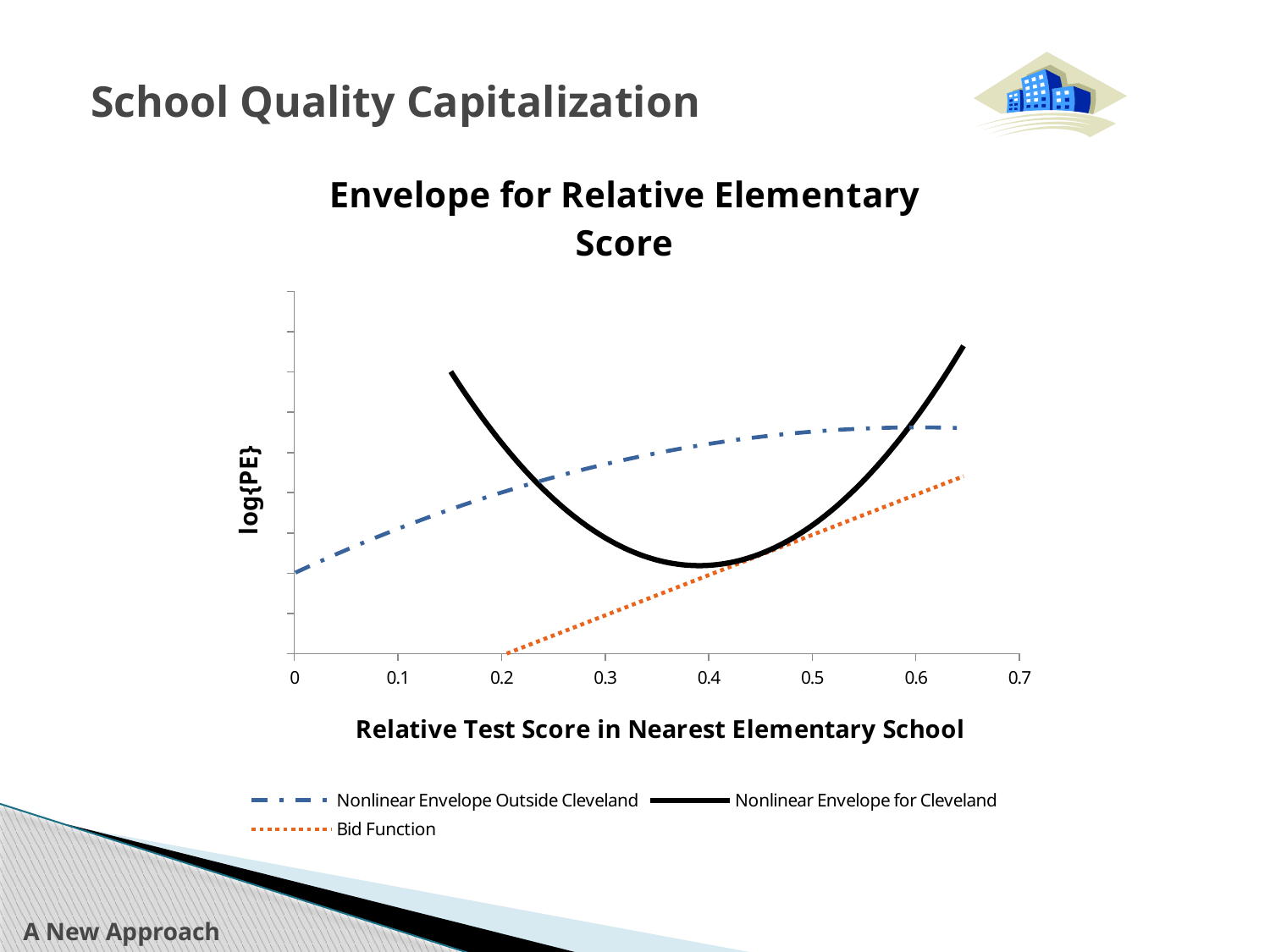
What is the title of the chart? Envelope for Relative Elementary Score What is the largest value labelled on the x axis? 0.7 Does the Bid Function rise or fall as the relative test score increases? Rises Near which x-axis tick does the Nonlinear Envelope for Cleveland reach its lowest point? 0.4 At a relative test score of 0.2, which series is higher: Nonlinear Envelope for Cleveland or Bid Function? Nonlinear Envelope for Cleveland Does the Nonlinear Envelope for Cleveland first fall and then rise, or first rise and then fall, along the x axis? First falls and then rises At a relative test score of 0.3, which series is higher: Nonlinear Envelope Outside Cleveland or Nonlinear Envelope for Cleveland? Nonlinear Envelope Outside Cleveland What type of chart is shown on the slide? Line chart What is the label of the x axis? Relative Test Score in Nearest Elementary School How many series does the legend list? 3 At a relative test score of 0.3, which of the three series has the lowest value? Bid Function Does the Nonlinear Envelope Outside Cleveland rise or fall as the relative test score increases? Rises